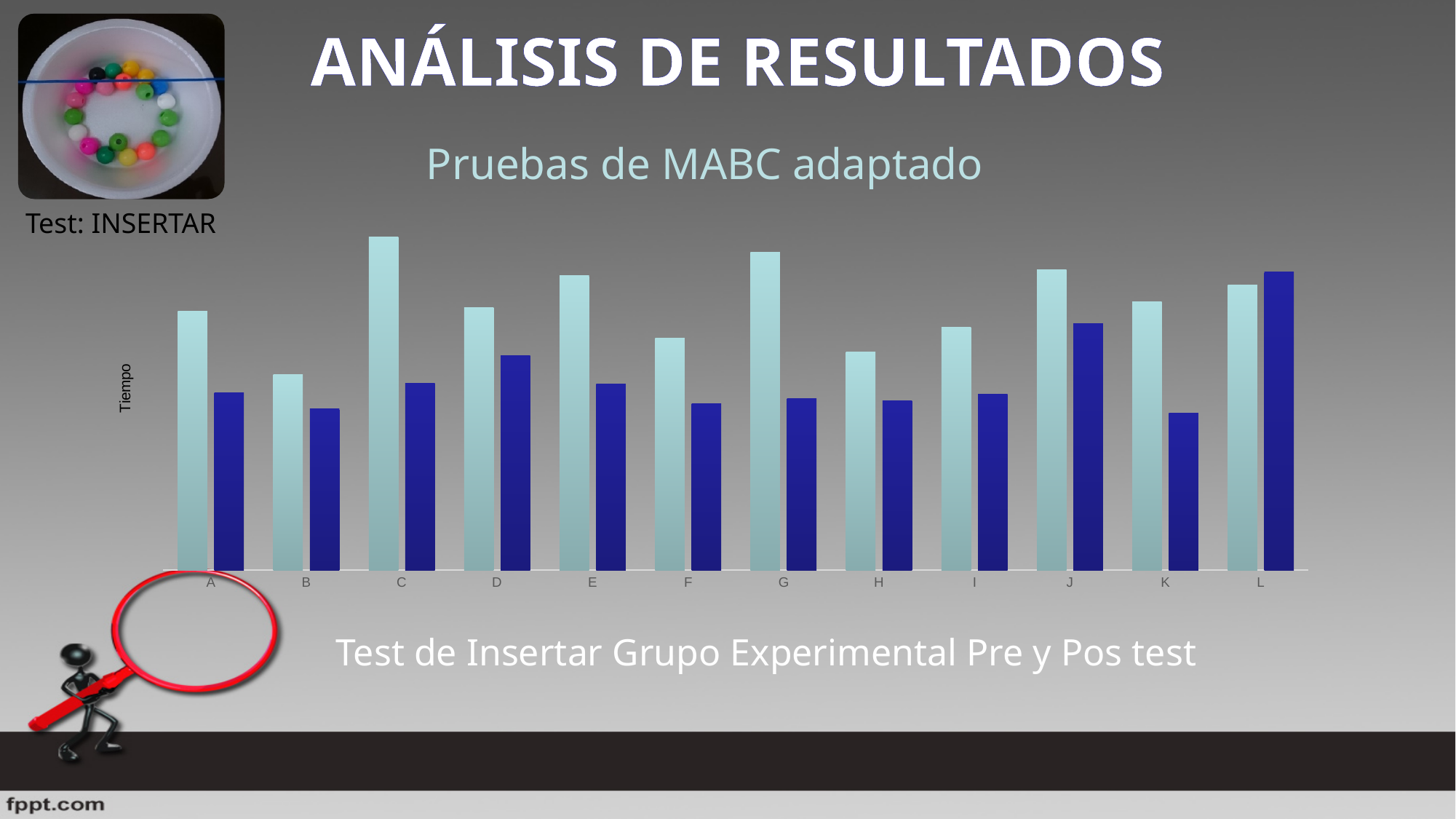
In category A, which bar is taller, the light blue one or the dark blue one? the light blue one Which category has the shortest light blue bar? B How many categories are shown along the x axis of the chart? 12 What caption appears below the chart? Test de Insertar Grupo Experimental Pre y Pos test Which category has the tallest light blue bar? C In category L, which bar is taller, the light blue one or the dark blue one? the dark blue one What type of chart is shown on the slide? bar chart How many bars are plotted for each category in the chart? 2 Which category has a taller dark blue bar, J or H? J What is the label on the vertical axis of the chart? Tiempo Which category has the tallest dark blue bar? L